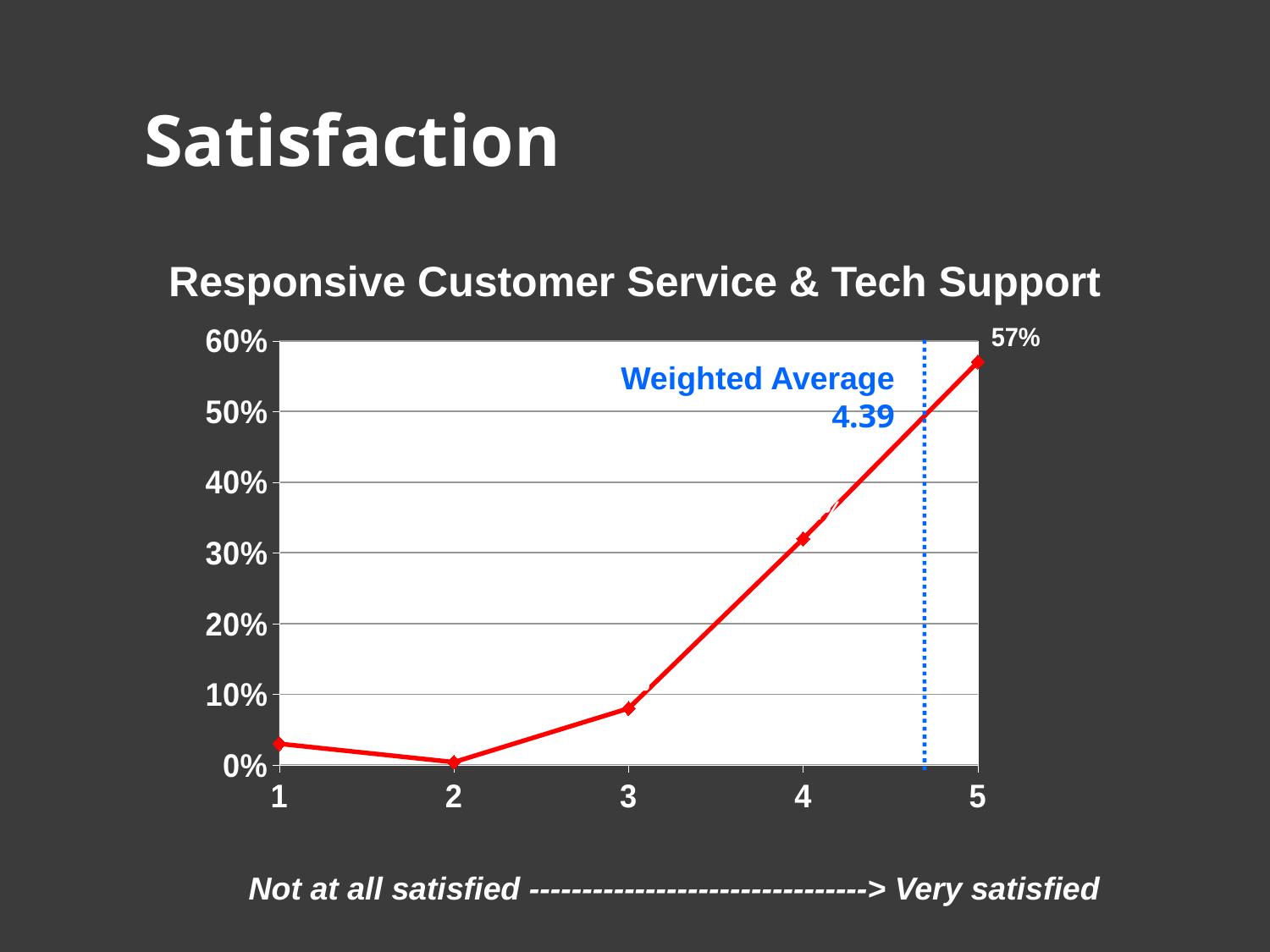
Which rating has a larger value, 3 or 4? 4 Is the value for rating 4 greater or less than 20%? greater Which rating has the highest value in the chart? 5 Do the values rise or fall from rating 2 to rating 5? rise What weighted average is annotated on the chart? 4.39 What is the title of the chart? Responsive Customer Service & Tech Support Is the value for rating 3 greater or less than 10%? less How many rating categories are plotted along the x axis? 5 Is the value for rating 4 greater or less than 40%? less Which rating has the lowest value in the chart? 2 What is the value for rating 5 in the Responsive Customer Service & Tech Support chart? 57% What kind of chart is shown on the slide? line chart